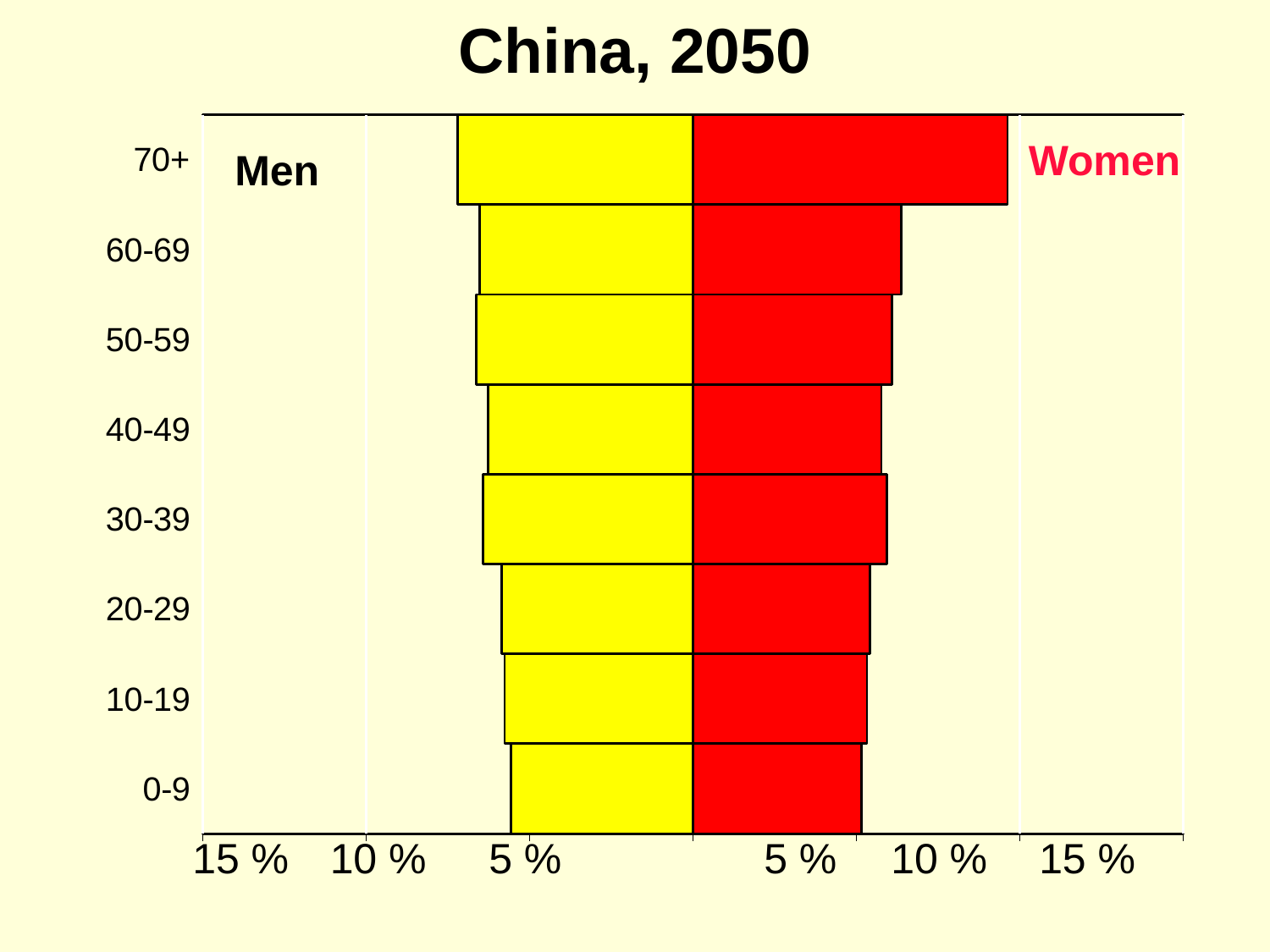
Which age group has the largest share of Men? 70+ Is the value for Women aged 70+ greater or less than 10 %? less How many age groups are shown on the chart? 8 For the 70+ age group, which is larger, the Men bar or the Women bar? Women Which age group has the largest share of Women? 70+ Is the value for Men aged 70+ greater or less than 5 %? greater How many series does the chart show? 2 What kind of chart is shown on the slide? bar chart What colour are the bars for Women? red Is the value for Women aged 70+ greater or less than 5 %? greater What is the title of the chart? China, 2050 Do the bar lengths rise or fall going from the 0-9 age group up to the 70+ age group? rise